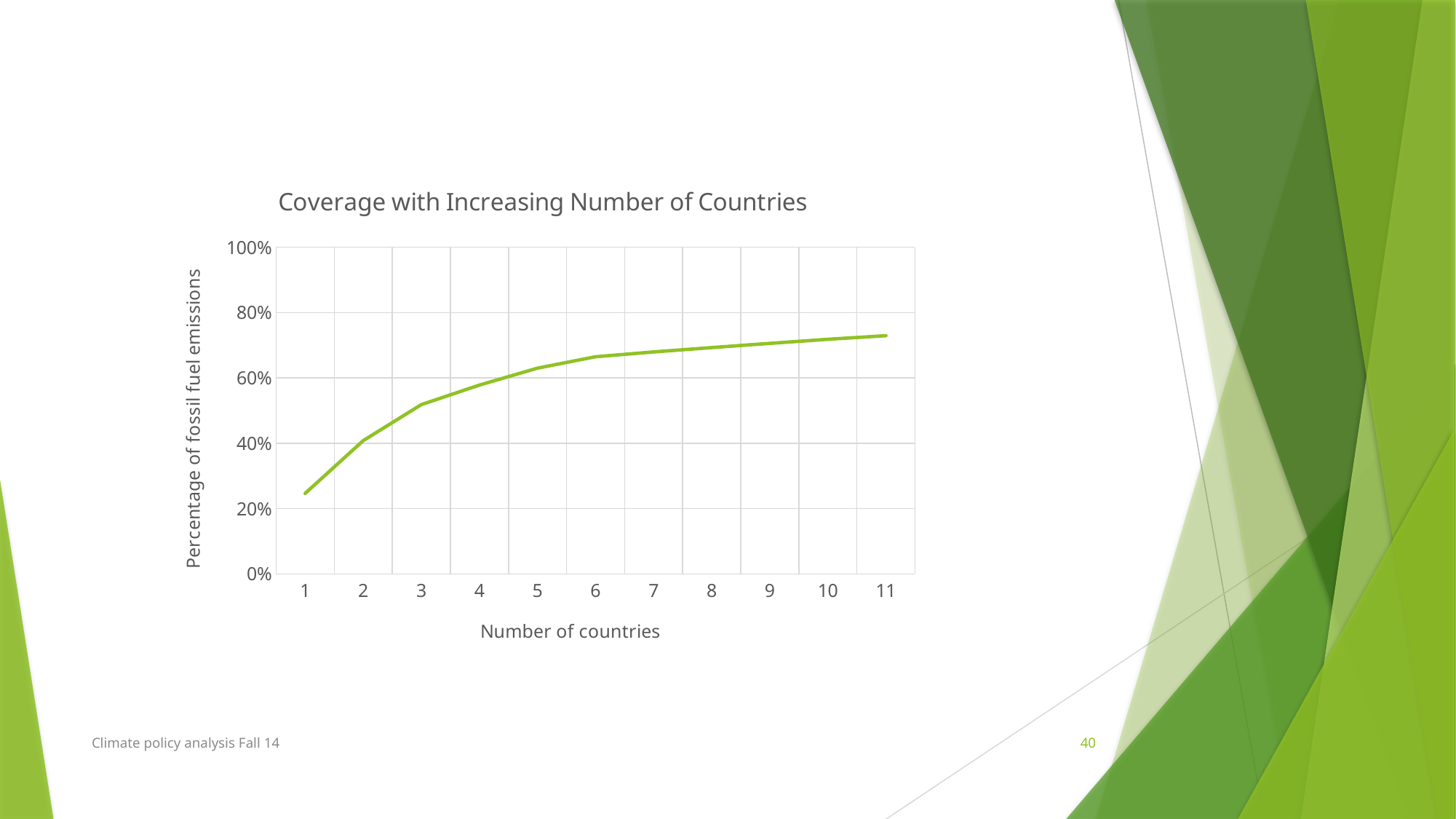
Is the value for 3 countries greater or less than 40%? greater Is the value for 1 country greater or less than 40%? less At which number of countries is the percentage of fossil fuel emissions highest? 11 How many points are plotted on the line? 11 What kind of chart is shown on the slide? Line chart Which has a higher percentage of fossil fuel emissions, 3 countries or 6 countries? 6 countries Is the value for 1 country greater or less than 20%? greater What is the title of the chart? Coverage with Increasing Number of Countries At which number of countries is the percentage of fossil fuel emissions lowest? 1 What is the label of the y axis? Percentage of fossil fuel emissions Do the values rise or fall as the number of countries increases? Rise